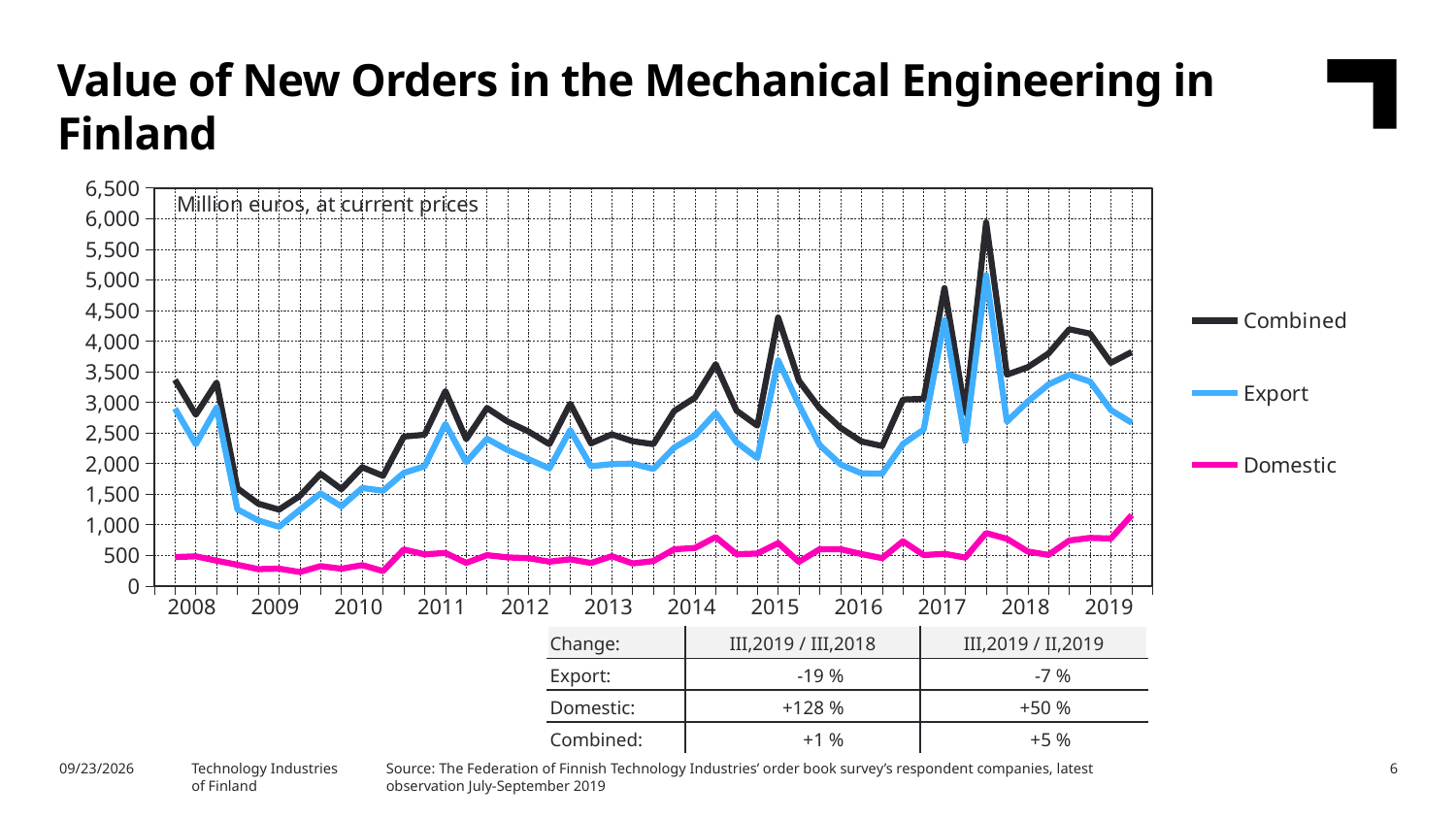
Is the Domestic value at the end of 2019 greater or less than 1,500? less How many series does the legend list? 3 According to the table, what is the Export change for III,2019 / III,2018? -19 % Which series has the lowest values throughout the chart? Domestic How many years are labelled on the x axis? 12 Which series are listed in the legend? Combined, Export, Domestic What unit is stated inside the chart area? Million euros, at current prices Does the Export series rise or fall from 2018 to 2019? fall Is the peak value of the Combined series in 2017 greater or less than 5,500? greater What type of chart is shown on the slide? line chart Is the peak value of the Export series in 2017 greater or less than 4,500? greater Which series has the highest values throughout the chart? Combined